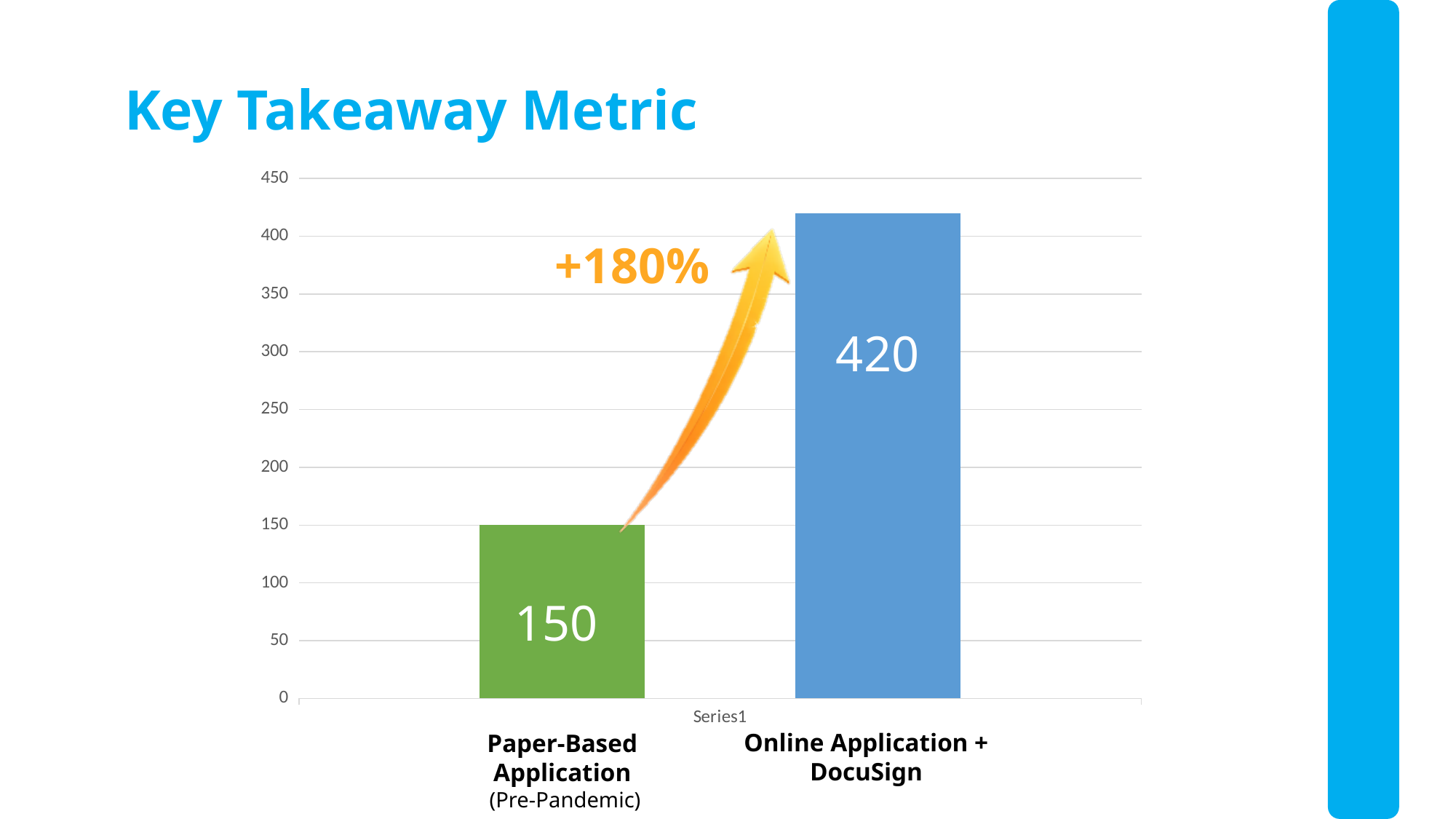
How many bars are plotted in the chart? 2 Which category has the highest value? Online Application + DocuSign Which is larger, the value for Paper-Based Application or the value for Online Application + DocuSign? Online Application + DocuSign What kind of chart is shown on the slide? bar chart What percentage increase is annotated on the chart between the two bars? +180% What is the highest value shown on the vertical axis? 450 Is the value for Online Application + DocuSign greater or less than 400? greater Which category has the lowest value? Paper-Based Application (Pre-Pandemic) What is the value for Paper-Based Application (Pre-Pandemic)? 150 What is the difference between the Online Application + DocuSign value and the Paper-Based Application value? 270 What is the title of the slide containing the chart? Key Takeaway Metric What is the value for Online Application + DocuSign? 420